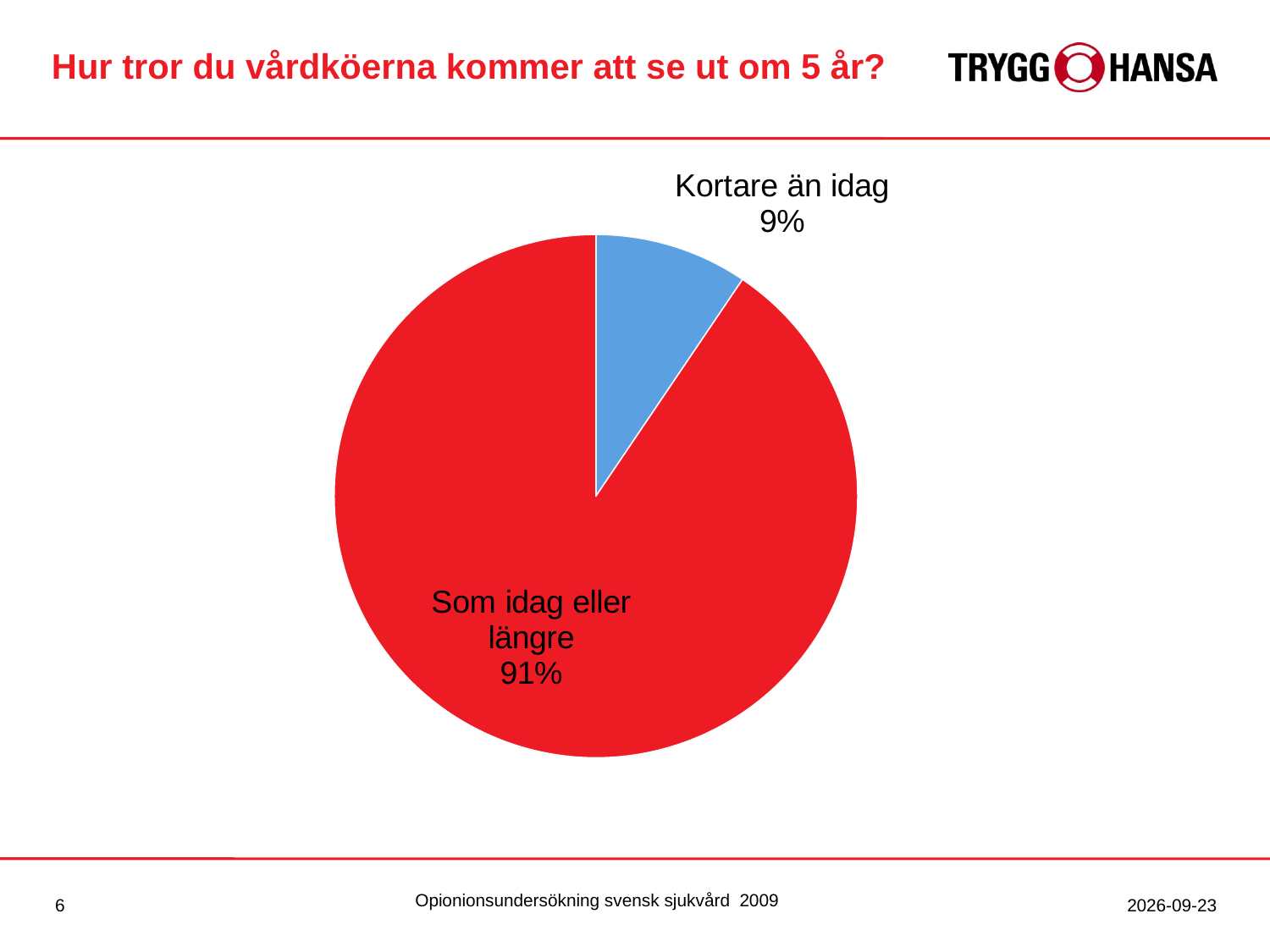
What share of the pie is labelled "Kortare än idag"? 9% What share of the pie is labelled "Som idag eller längre"? 91% Which slice of the pie is the largest? Som idag eller längre Which slice of the pie is the smallest? Kortare än idag What is the difference in percentage points between the "Som idag eller längre" slice and the "Kortare än idag" slice? 82 What is the title of the slide containing the pie chart? Hur tror du vårdköerna kommer att se ut om 5 år? How many slices does the pie chart have? 2 Which is larger, the "Kortare än idag" slice or the "Som idag eller längre" slice? Som idag eller längre What colour is the "Kortare än idag" slice? blue What kind of chart is shown on the slide? pie chart Is the share for "Kortare än idag" greater or less than 10%? less